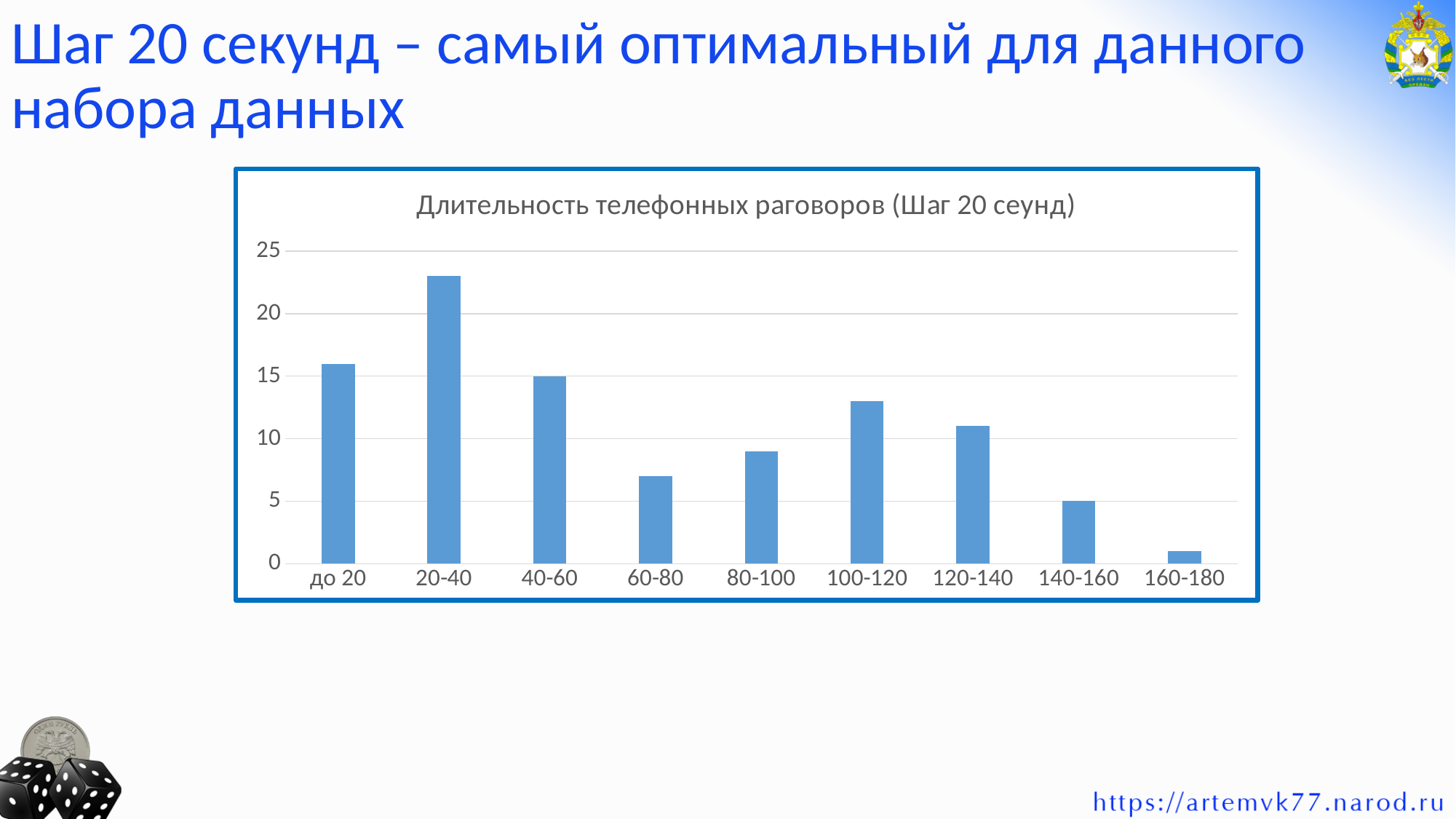
Which is larger, the value for 120-140 or the value for 140-160? 120-140 What is the title of the chart? Длительность телефонных раговоров (Шаг 20 сеунд) How many categories are shown on the x axis of the chart? 9 Is the value for 20-40 greater or less than 20? greater Is the value for 60-80 greater or less than 10? less Which category has the highest bar? 20-40 Which category has the lowest bar? 160-180 What is the value for the 140-160 category? 5 What is the value for the 40-60 category? 15 Is the value for 100-120 greater or less than 10? greater Which is larger, the value for до 20 or the value for 80-100? до 20 What kind of chart is shown on the slide? bar chart